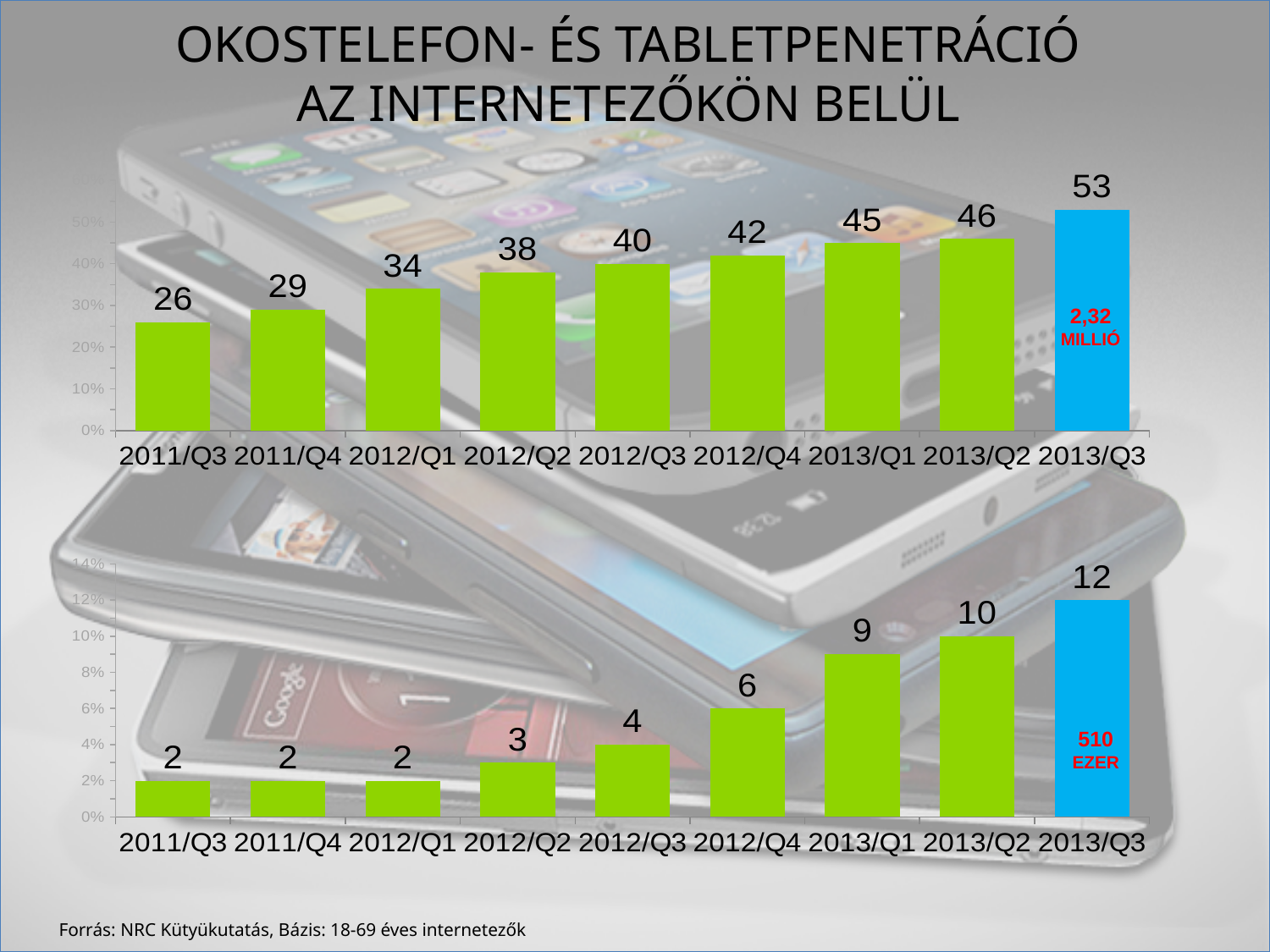
In the top chart, which quarter has the highest value? 2013/Q3 In the top chart, what is the value for 2013/Q3? 53 How many quarters are shown on the x axis of the bottom chart? 9 In the top chart, which quarter has the lowest value? 2011/Q3 In the bottom chart, which quarter has the highest value? 2013/Q3 In the bottom chart, what is the difference between the values for 2013/Q2 and 2012/Q2? 7 In the top chart, what is the value for 2011/Q3? 26 What kind of chart is the top chart? bar chart In the bottom chart, what is the value for 2013/Q3? 12 In the bottom chart, what is the value for 2012/Q4? 6 In the top chart, what is the difference between the values for 2013/Q3 and 2011/Q3? 27 In the top chart, do the values rise or fall from 2011/Q3 to 2013/Q3? rise